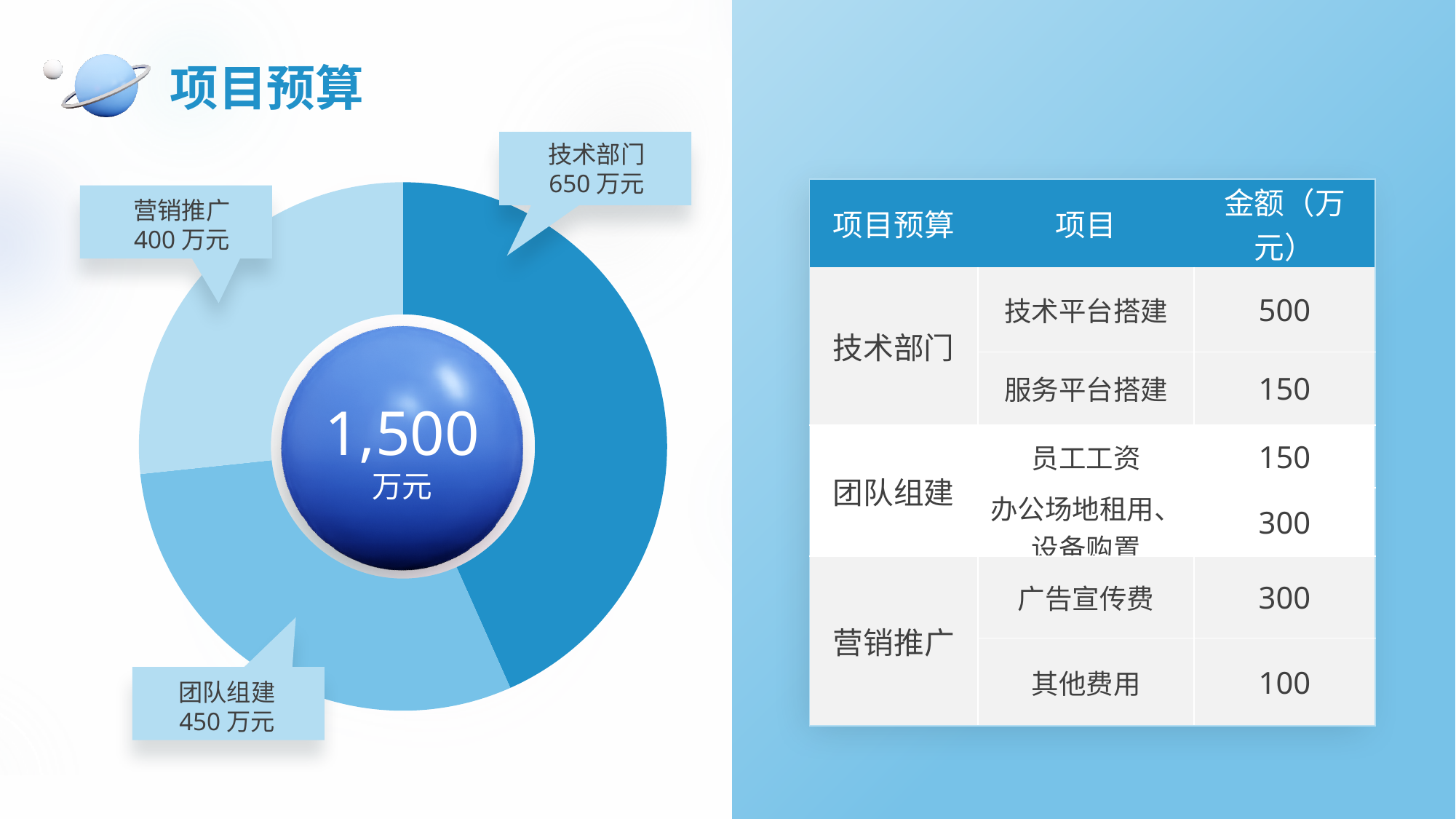
What share of the total does 团队组建 represent in the pie chart? 30% What total value is shown in the centre of the pie chart? 1,500 万元 What is the budget value shown for 团队组建 in the pie chart? 450 万元 Which category has the smallest slice in the pie chart? 营销推广 How many categories does the pie chart show? 3 What kind of chart is shown on the left of the slide? Doughnut chart What is the difference between the 团队组建 and 营销推广 values in the pie chart? 50 万元 What is the budget value shown for 营销推广 in the pie chart? 400 万元 Which is larger in the pie chart, 技术部门 or 团队组建? 技术部门 What is the budget value shown for 技术部门 in the pie chart? 650 万元 Which category has the largest slice in the pie chart? 技术部门 What is the difference between the 技术部门 and 营销推广 values in the pie chart? 250 万元